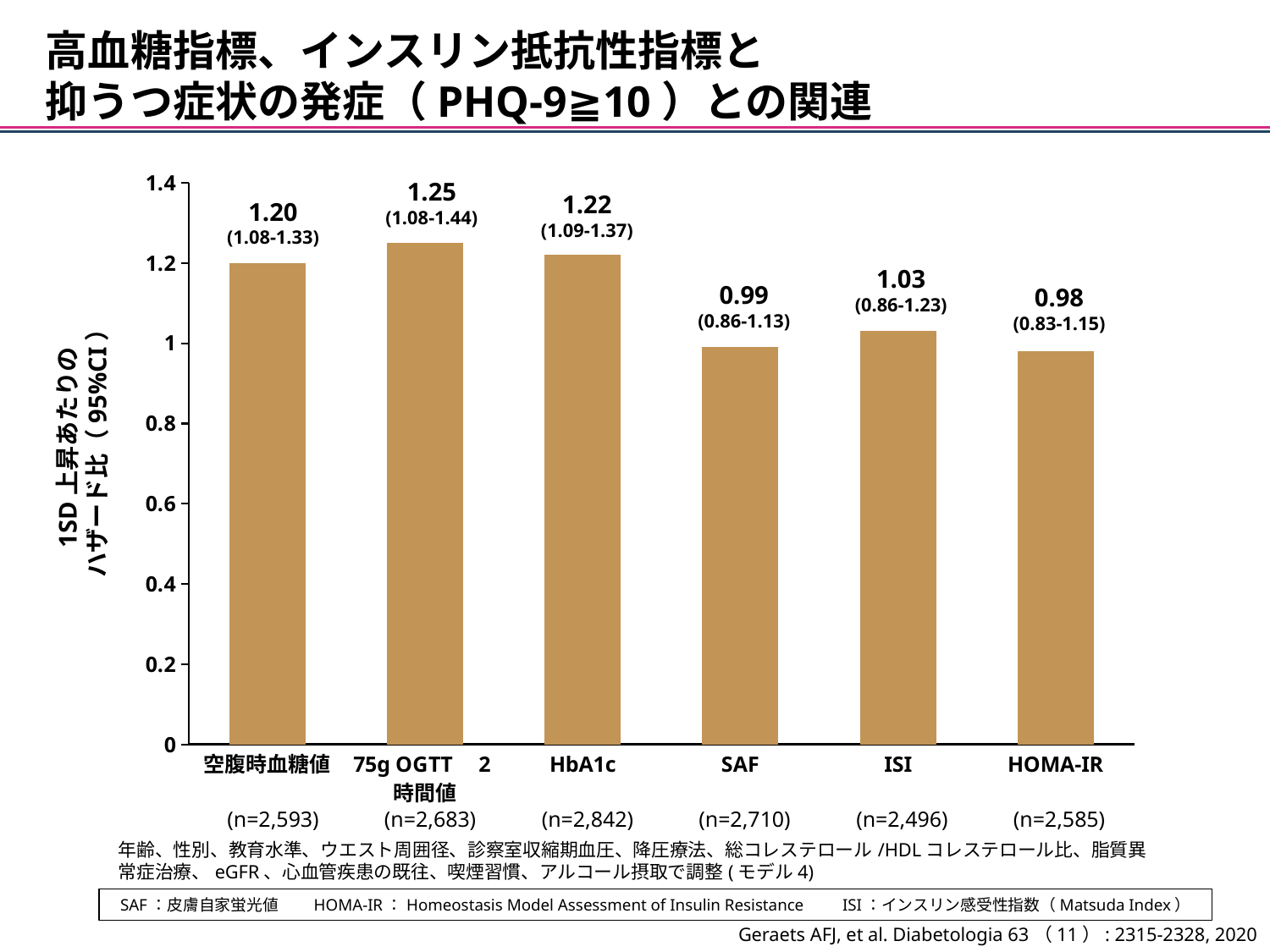
Which indicator has the lowest hazard ratio? HOMA-IR Which has a larger hazard ratio, ISI or SAF? ISI What kind of chart is shown on the slide? bar chart What is the hazard ratio for SAF? 0.99 What is the difference between the hazard ratios for 75g OGTT 2時間値 and 空腹時血糖値? 0.05 Which indicator has the highest hazard ratio? 75g OGTT 2時間値 What is the sample size (n) shown for HbA1c? n=2,842 Is the hazard ratio for 空腹時血糖値 greater or less than 1? greater What is the 95% confidence interval shown for 75g OGTT 2時間値? (1.08-1.44) What is the hazard ratio for HbA1c? 1.22 How many indicators are plotted in the chart? 6 What is the hazard ratio for HOMA-IR? 0.98